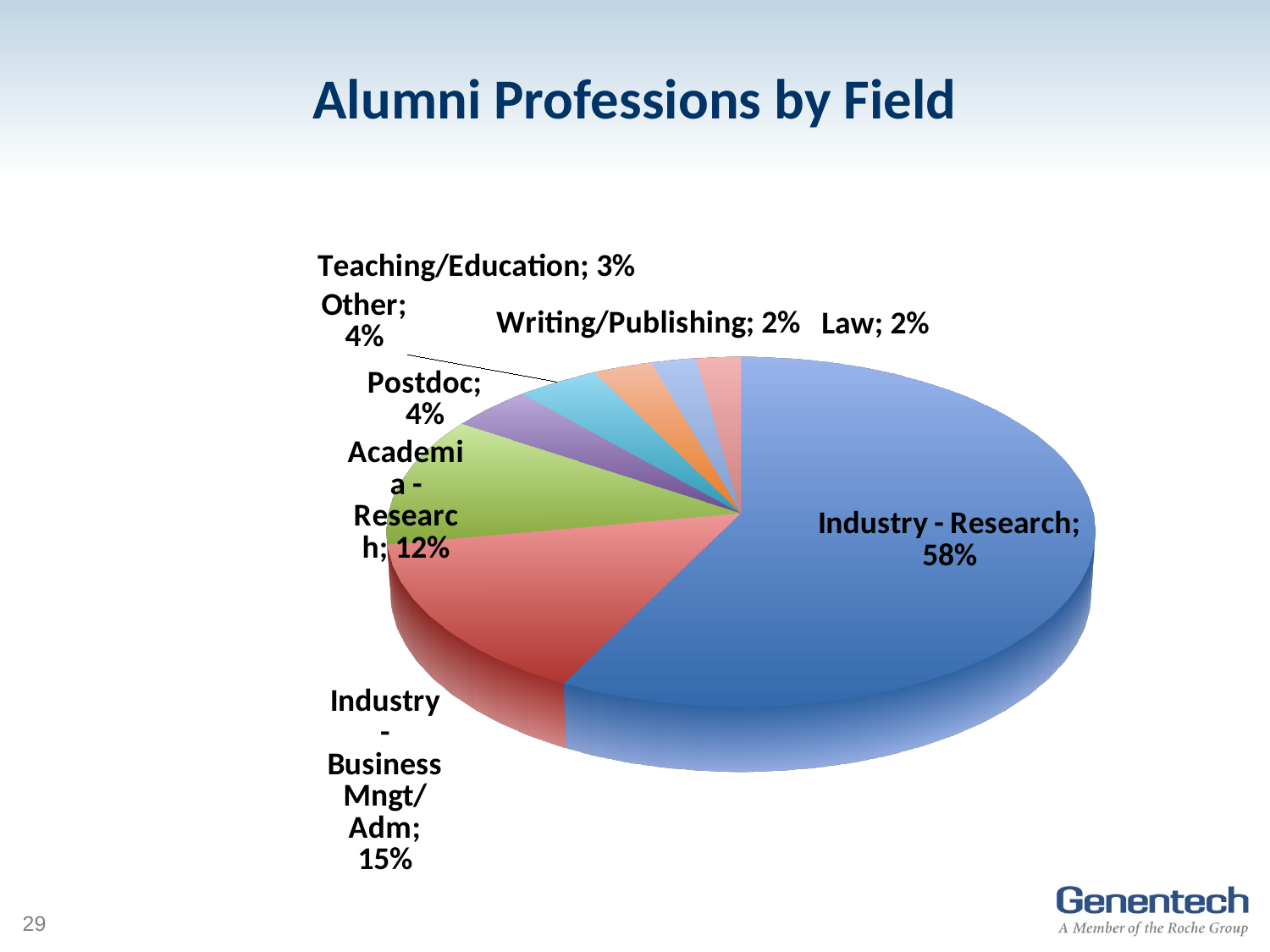
Which has a larger share of alumni, Academia - Research or Postdoc? Academia - Research How many profession categories are shown in the pie chart? 8 What percentage of alumni are in Law? 2% What percentage of alumni are in Industry - Business Mngt/Adm? 15% What is the difference in percentage points between Industry - Research and Industry - Business Mngt/Adm? 43 What share of alumni are in Industry - Research? 58% What type of chart is shown on the slide? Pie chart What is the title of the chart? Alumni Professions by Field What is the combined share of Postdoc and Other? 8% What percentage of alumni are in Teaching/Education? 3% Which profession field has the largest share of alumni? Industry - Research What percentage of alumni are in Academia - Research? 12%